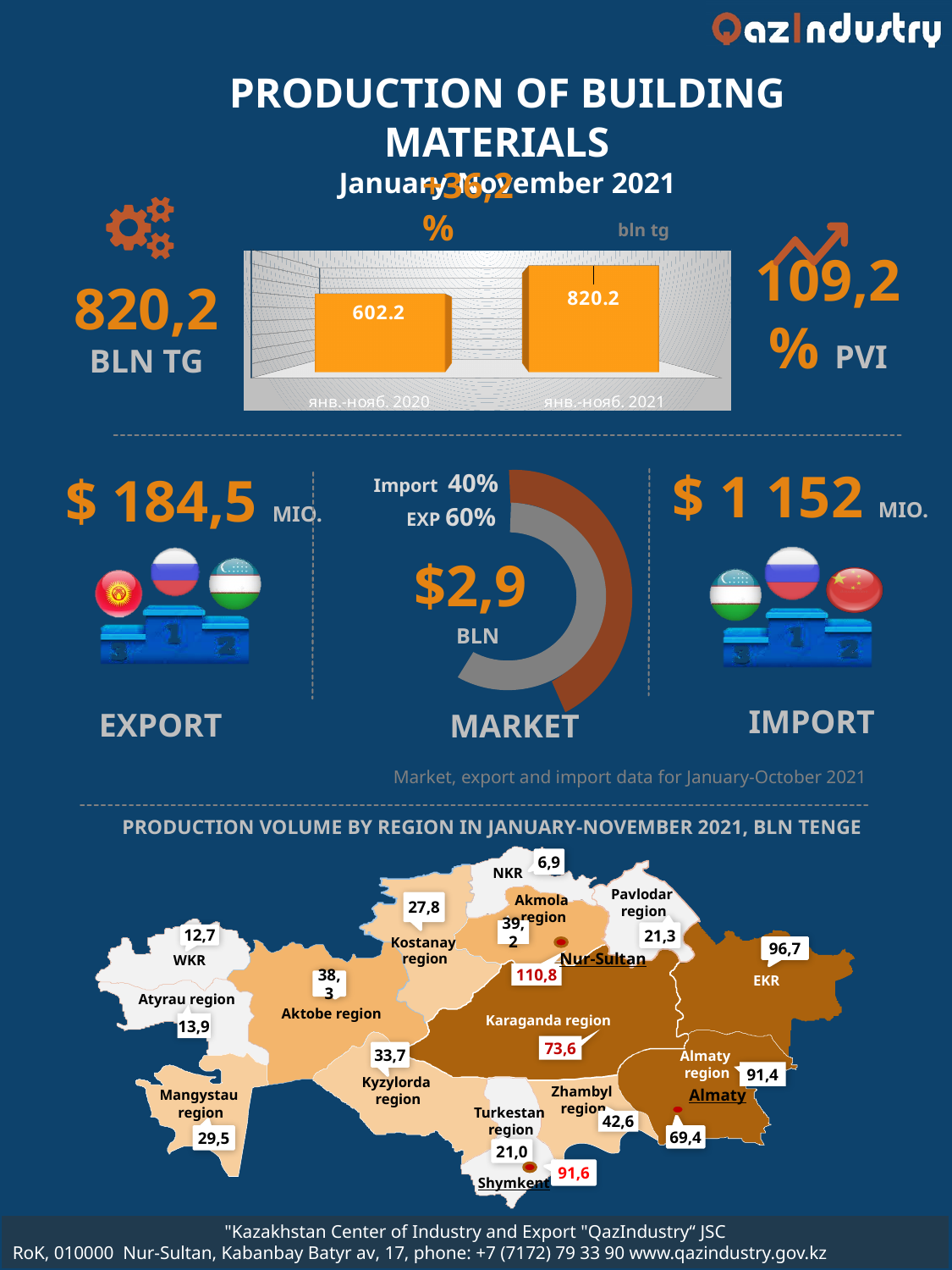
What kind of chart is used at the top of the slide to compare янв.-нояб. 2020 and янв.-нояб. 2021? bar chart In the MARKET donut chart, which segment is larger, Import or EXP? EXP In the MARKET donut chart, what share is labelled EXP? 60% In the bar chart at the top of the slide, what is the value for янв.-нояб. 2020? 602.2 How many bars are shown in the bar chart at the top of the slide? 2 On the regional production map, which region has the lowest production volume? NKR In the bar chart at the top of the slide, what is the difference between the 2021 and 2020 values? 218.0 In the bar chart at the top of the slide, what is the value for янв.-нояб. 2021? 820.2 In the bar chart at the top of the slide, do the values rise or fall from 2020 to 2021? rise What value is shown in the centre of the MARKET donut chart? $2,9 BLN In the MARKET donut chart, what share is labelled Import? 40% In the bar chart at the top of the slide, which period has the higher value? янв.-нояб. 2021